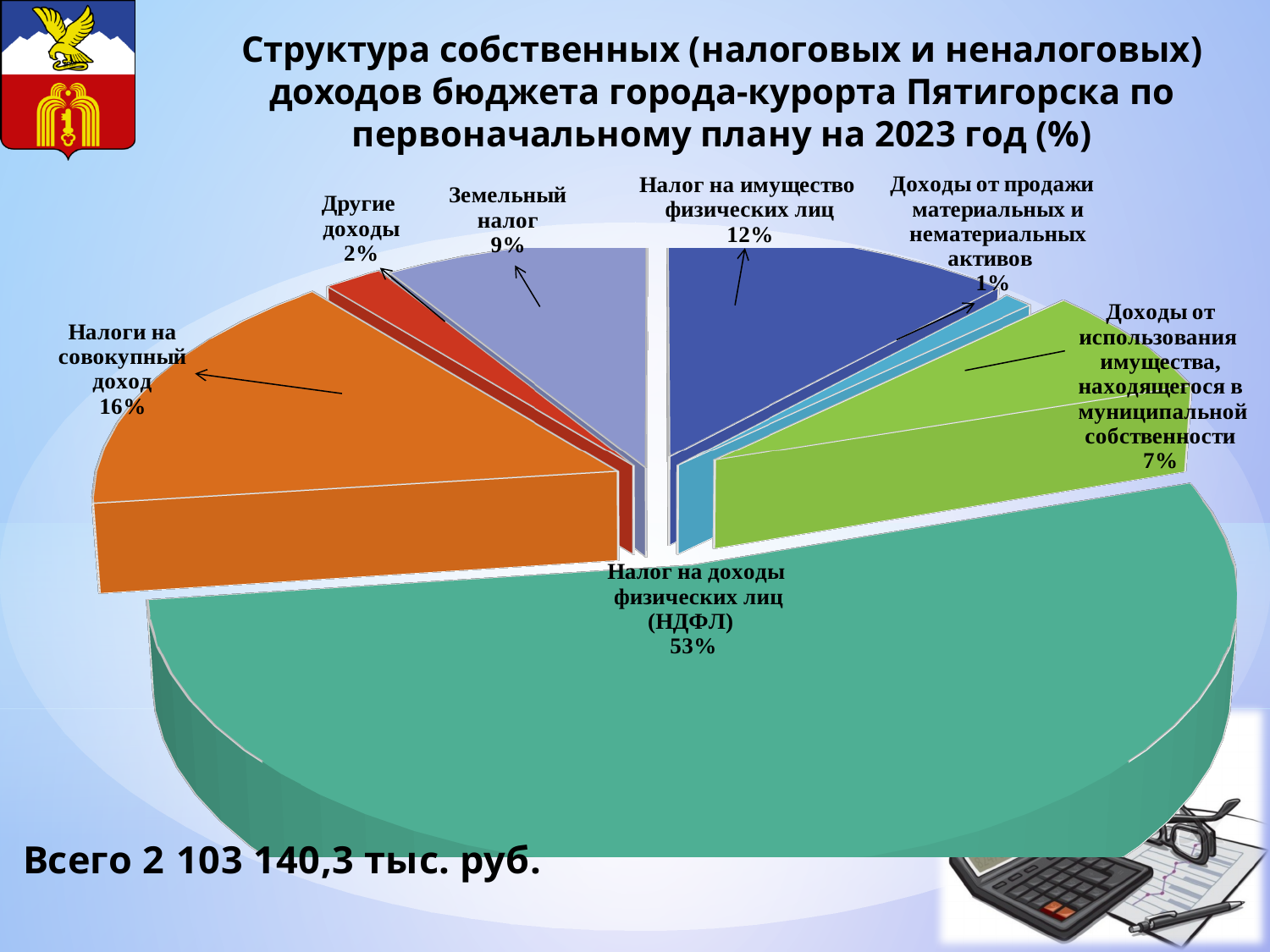
Какую долю составляют доходы от продажи материальных и нематериальных активов? 1% Какую долю составляет земельный налог? 9% Что больше: доля налогов на совокупный доход или доля налога на имущество физических лиц? Налоги на совокупный доход Какой тип диаграммы использован на слайде? Круговая диаграмма На сколько процентных пунктов доля налога на имущество физических лиц больше доли земельного налога? 3 Какую долю составляют налоги на совокупный доход? 16% Какая общая сумма собственных доходов указана на слайде? 2 103 140,3 тыс. руб. Сколько категорий доходов показано на диаграмме? 7 Какую долю составляют доходы от использования имущества, находящегося в муниципальной собственности? 7% Какую долю составляет налог на доходы физических лиц (НДФЛ) в структуре собственных доходов бюджета? 53% Какая категория доходов имеет наибольшую долю на диаграмме? Налог на доходы физических лиц (НДФЛ) Какая категория доходов имеет наименьшую долю на диаграмме? Доходы от продажи материальных и нематериальных активов